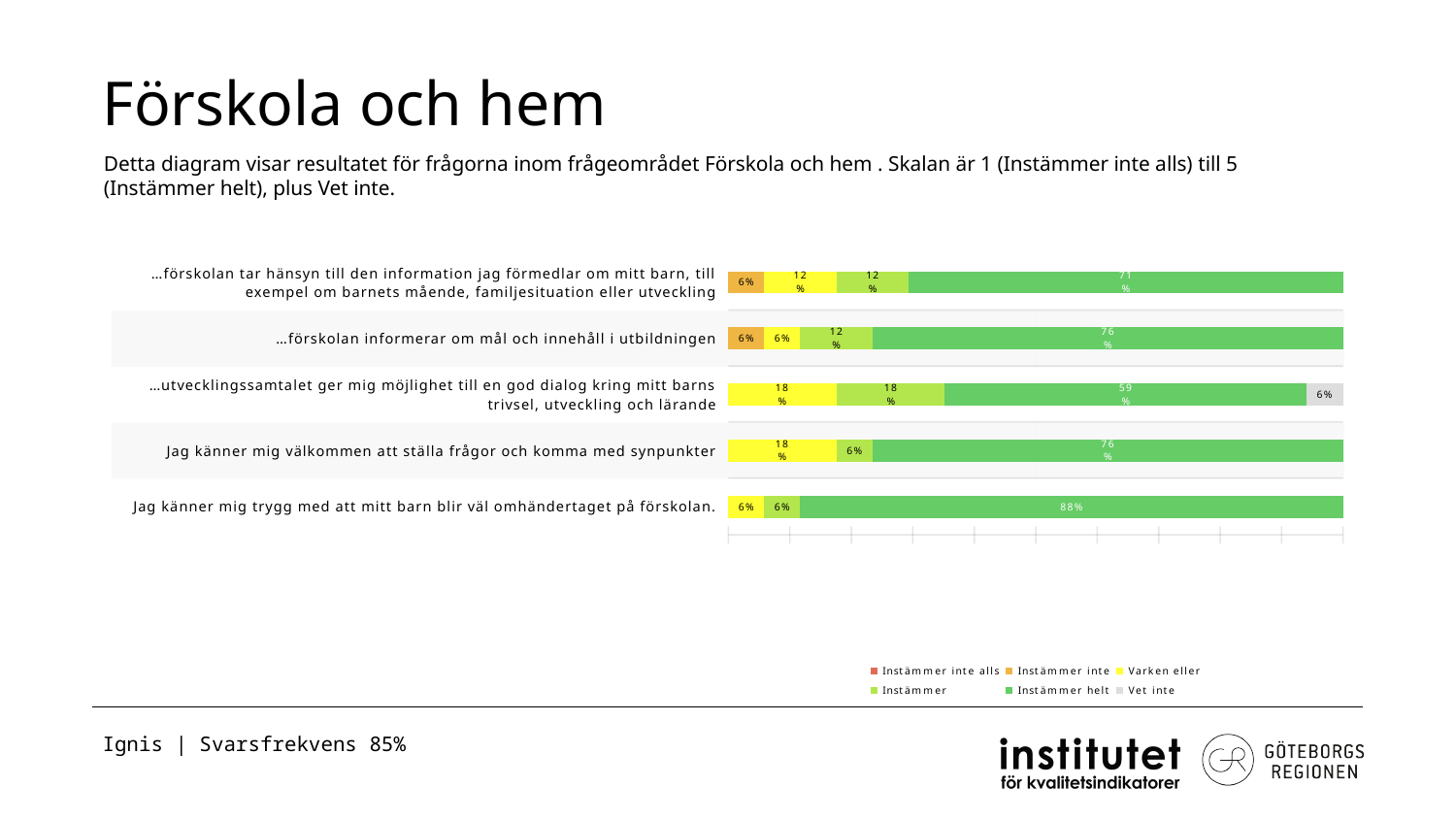
What is the 'Instämmer helt' value for 'Jag känner mig trygg med att mitt barn blir väl omhändertaget på förskolan.'? 88% What is the 'Instämmer helt' value for '…utvecklingssamtalet ger mig möjlighet till en god dialog kring mitt barns trivsel, utveckling och lärande'? 59% What is the difference between the 'Instämmer helt' values for 'Jag känner mig trygg med att mitt barn blir väl omhändertaget på förskolan.' and '…förskolan tar hänsyn till den information jag förmedlar om mitt barn, till exempel om barnets mående, familjesituation eller utveckling'? 17% Which question has the lowest 'Instämmer helt' value? …utvecklingssamtalet ger mig möjlighet till en god dialog kring mitt barns trivsel, utveckling och lärande How many questions (categories) are plotted in the chart? 5 Which question has the highest 'Instämmer helt' value? Jag känner mig trygg med att mitt barn blir väl omhändertaget på förskolan. How many series does the legend list? 6 What is the title of the slide containing the chart? Förskola och hem Which has the larger 'Instämmer helt' value: '…förskolan informerar om mål och innehåll i utbildningen' or '…utvecklingssamtalet ger mig möjlighet till en god dialog kring mitt barns trivsel, utveckling och lärande'? …förskolan informerar om mål och innehåll i utbildningen What is the 'Varken eller' value for 'Jag känner mig välkommen att ställa frågor och komma med synpunkter'? 18% What kind of chart is shown on the slide? bar chart What is the 'Vet inte' value for '…utvecklingssamtalet ger mig möjlighet till en god dialog kring mitt barns trivsel, utveckling och lärande'? 6%